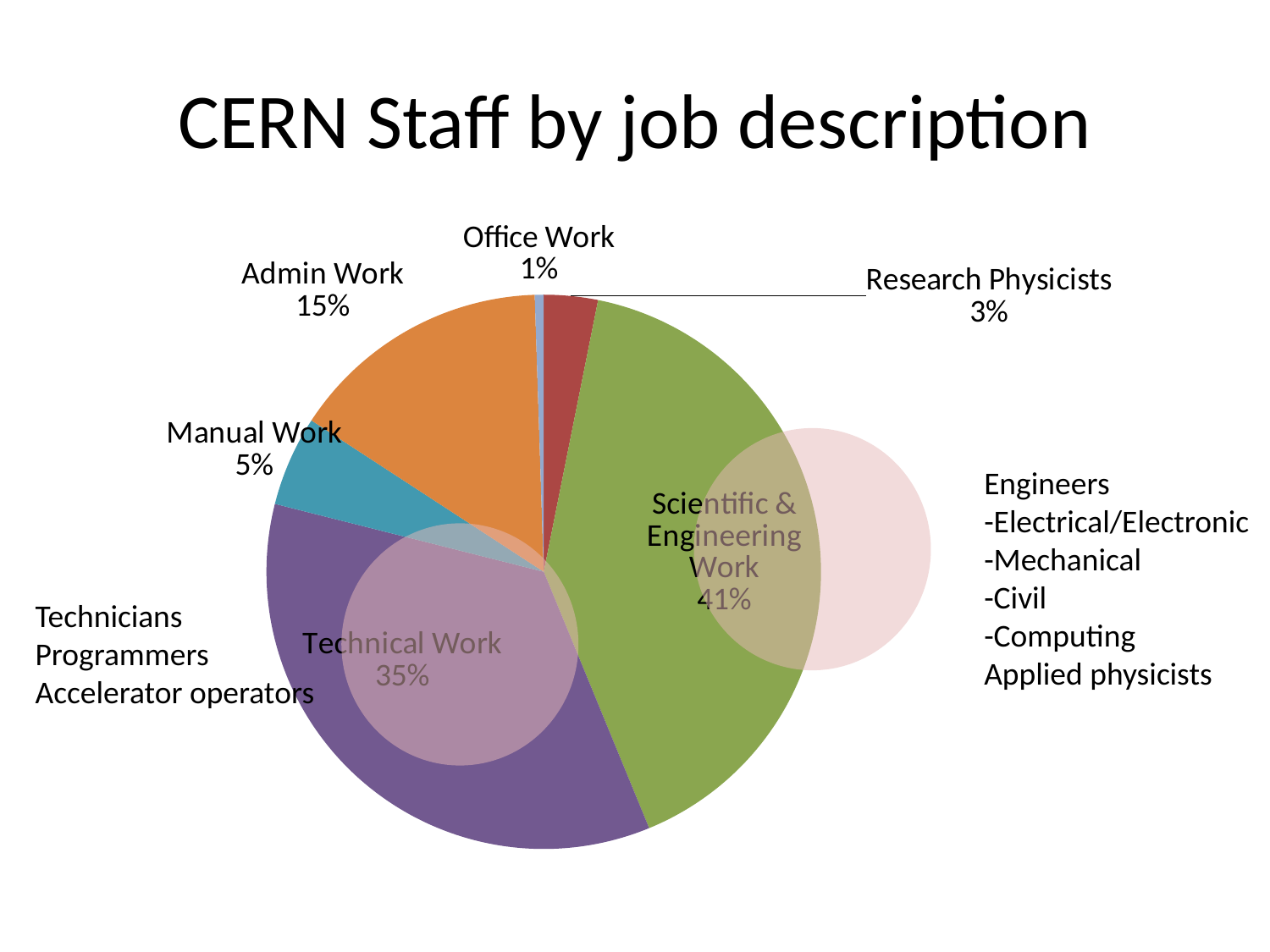
Which job category has the largest share of CERN staff? Scientific & Engineering Work Which job category has the smallest share of CERN staff? Office Work What percentage of CERN staff is in Manual Work? 5% What is the difference in percentage points between Scientific & Engineering Work and Technical Work? 6 What percentage of CERN staff is in Technical Work? 35% What percentage of CERN staff is in Scientific & Engineering Work? 41% What is the title of the chart? CERN Staff by job description How many job categories are shown in the pie chart? 6 What percentage of CERN staff are Research Physicists? 3% What percentage of CERN staff is in Admin Work? 15% What type of chart is shown on the slide? Pie chart Which is larger, the share for Admin Work or the share for Manual Work? Admin Work